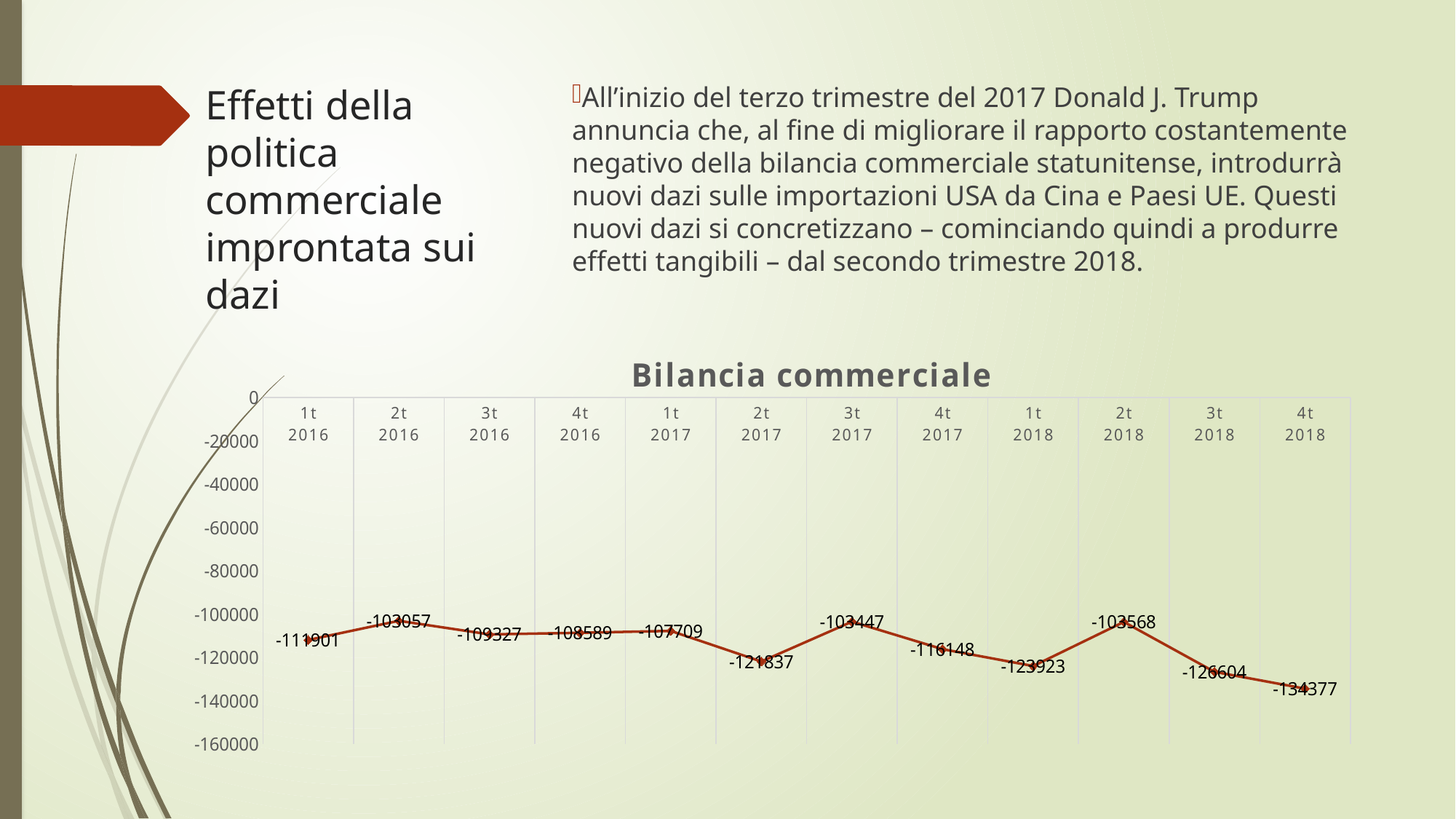
What is the value for 4t 2018 in the Bilancia commerciale chart? -134377 What is the value for 1t 2018 in the Bilancia commerciale chart? -123923 What kind of chart is the Bilancia commerciale chart? line chart Which quarter has the lowest value in the Bilancia commerciale chart? 4t 2018 What is the value for 2t 2017 in the Bilancia commerciale chart? -121837 What is the value for 1t 2016 in the Bilancia commerciale chart? -111901 Which is larger in the Bilancia commerciale chart, the value for 4t 2016 or the value for 3t 2018? 4t 2016 Is the value for 4t 2018 in the Bilancia commerciale chart greater or less than -120000? less What is the difference between the values for 3t 2018 and 4t 2018 in the Bilancia commerciale chart? 7773 What is the title of the chart on the slide? Bilancia commerciale How many quarters are plotted in the Bilancia commerciale chart? 12 What is the difference between the values for 1t 2017 and 2t 2017 in the Bilancia commerciale chart? 14128